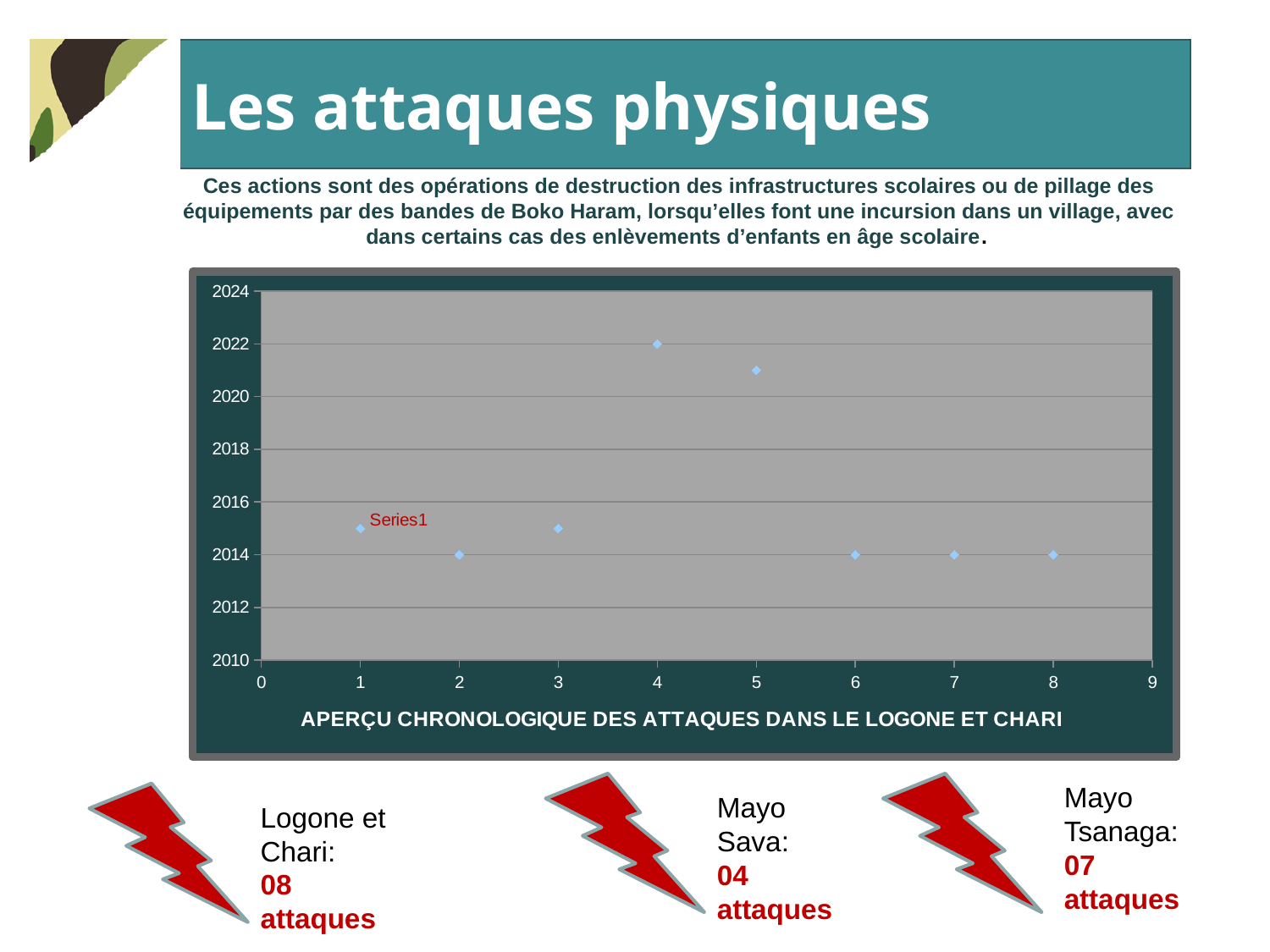
What is the difference between the y value at x = 4 and the y value at x = 2? 8 Is the y value of the point at x = 3 greater or less than 2016? less What kind of chart is shown on the slide? scatter chart What is the y value of the point at x = 2? 2014 What is the y value of the point at x = 8? 2014 Which point has the larger y value, the one at x = 4 or the one at x = 6? x = 4 What is the y value of the point at x = 4? 2022 How many data points are plotted on the chart? 8 What is the title printed below the chart? APERÇU CHRONOLOGIQUE DES ATTAQUES DANS LE LOGONE ET CHARI Is the y value of the point at x = 5 greater or less than 2020? greater At which x value is the highest point on the chart? 4 What is the name of the series labelled on the chart? Series1